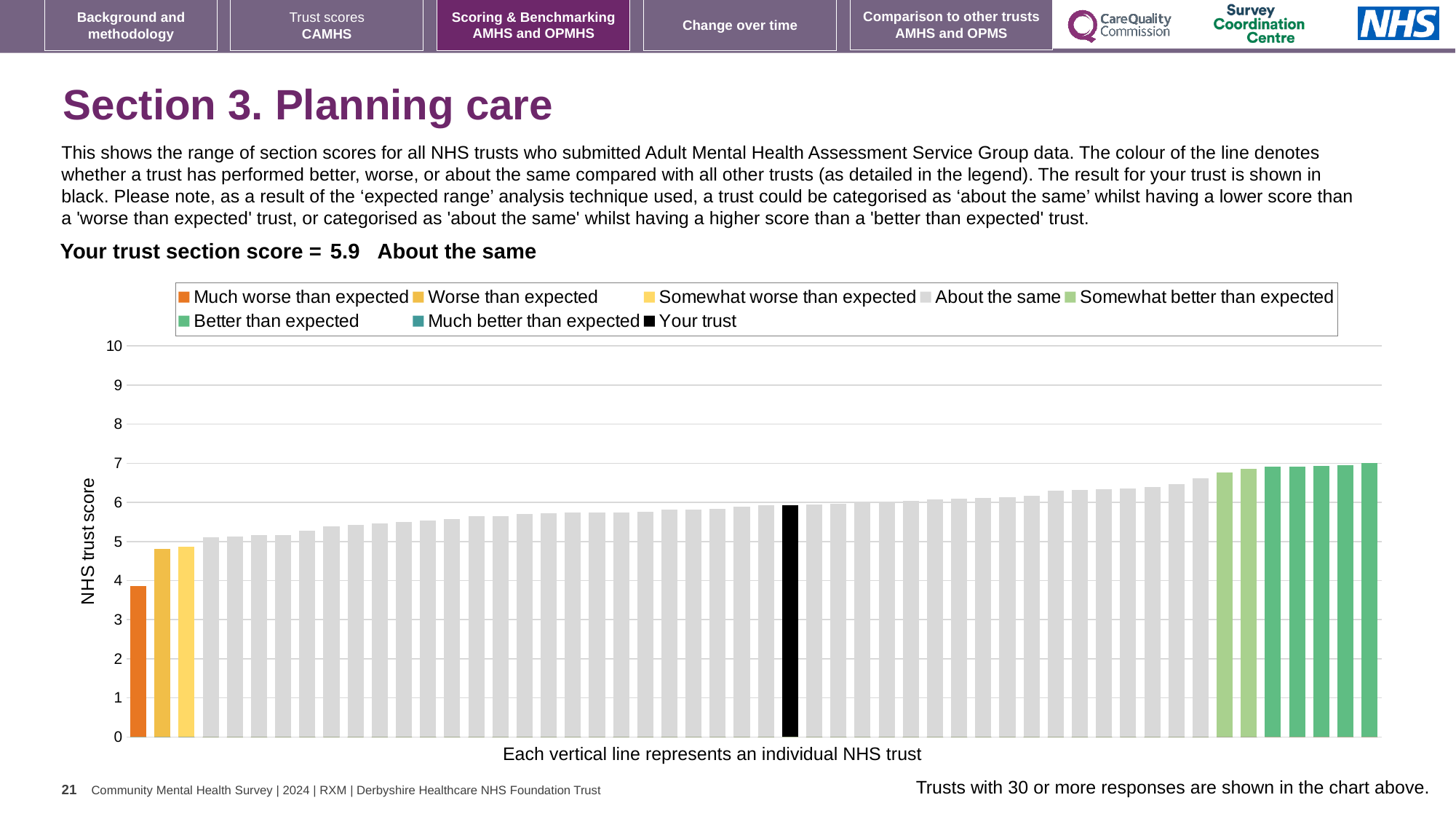
How many bars are coloured orange (Much worse than expected)? 1 Is the value of the tallest bar in the chart greater or less than 8? less What is your trust's section score for Planning care? 5.9 How many bars are coloured dark green (Better than expected)? 5 Do the bar values rise or fall from left to right along the x axis? rise What kind of chart is shown on the slide? bar chart What colour is used for the 'Your trust' bar in the chart? black How many entries does the chart legend list? 8 What is the label on the vertical axis of the chart? NHS trust score Which legend category does the tallest bar belong to? Better than expected Is the value of the black 'Your trust' bar greater or less than 5? greater Is the value of the shortest (orange) bar greater or less than 3? greater